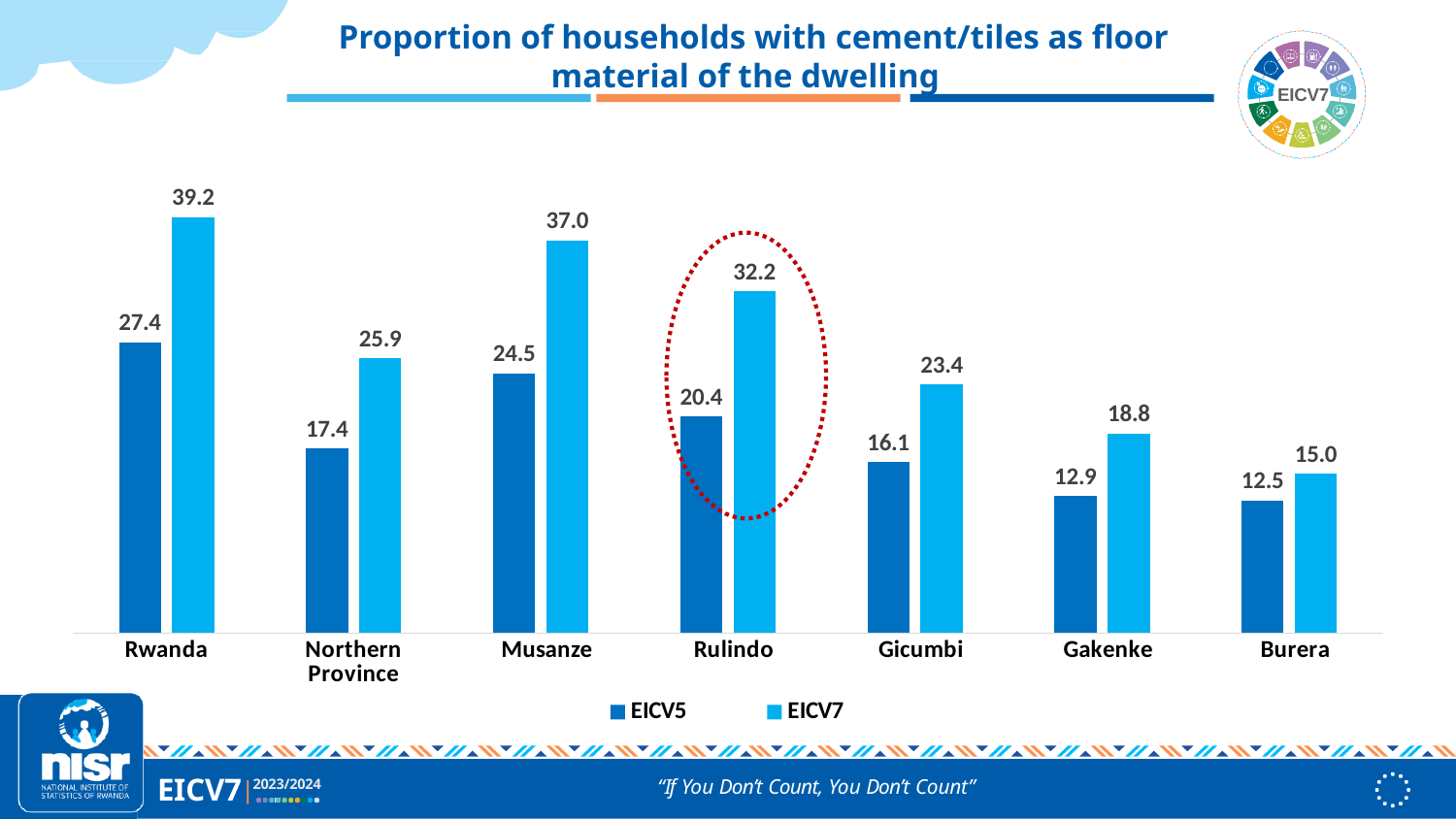
Which category has the highest EICV7 value? Rwanda What is the difference between the EICV7 and EICV5 values for Burera? 2.5 Which is larger: the EICV7 value for Gicumbi or the EICV7 value for Northern Province? Northern Province What is the EICV7 value for Gakenke? 18.8 Which category has the lowest EICV5 value? Burera What kind of chart is shown on the slide? Bar chart How many series does the legend list? 2 What is the difference between the EICV7 and EICV5 values for Musanze? 12.5 Which category is highlighted with a red dotted circle? Rulindo What is the EICV7 value for Rwanda? 39.2 What is the EICV5 value for Rulindo? 20.4 How many categories are shown on the x axis? 7